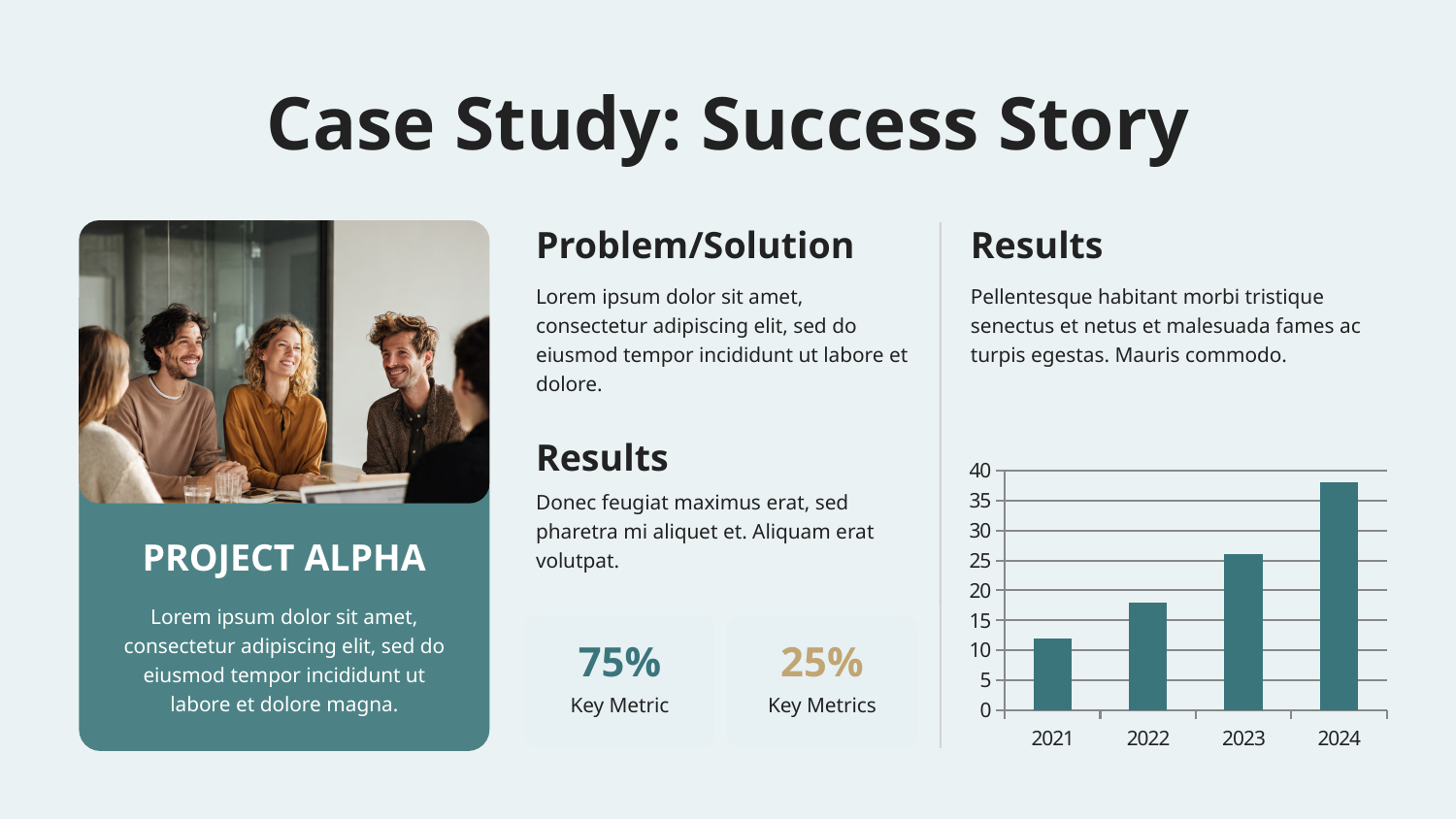
What is the first year shown on the chart's horizontal axis? 2021 Which year has the lowest bar in the chart? 2021 How many bars does the chart show? 4 Do the values rise or fall from 2021 to 2024? rise Is the value for 2024 greater or less than 35? greater Which is larger, the value for 2022 or the value for 2023? 2023 Which year has the highest bar in the chart? 2024 Is the value for 2022 greater or less than 20? less Is the value for 2021 greater or less than 15? less What is the highest value shown on the chart's vertical axis? 40 What kind of chart is shown on the slide? bar chart